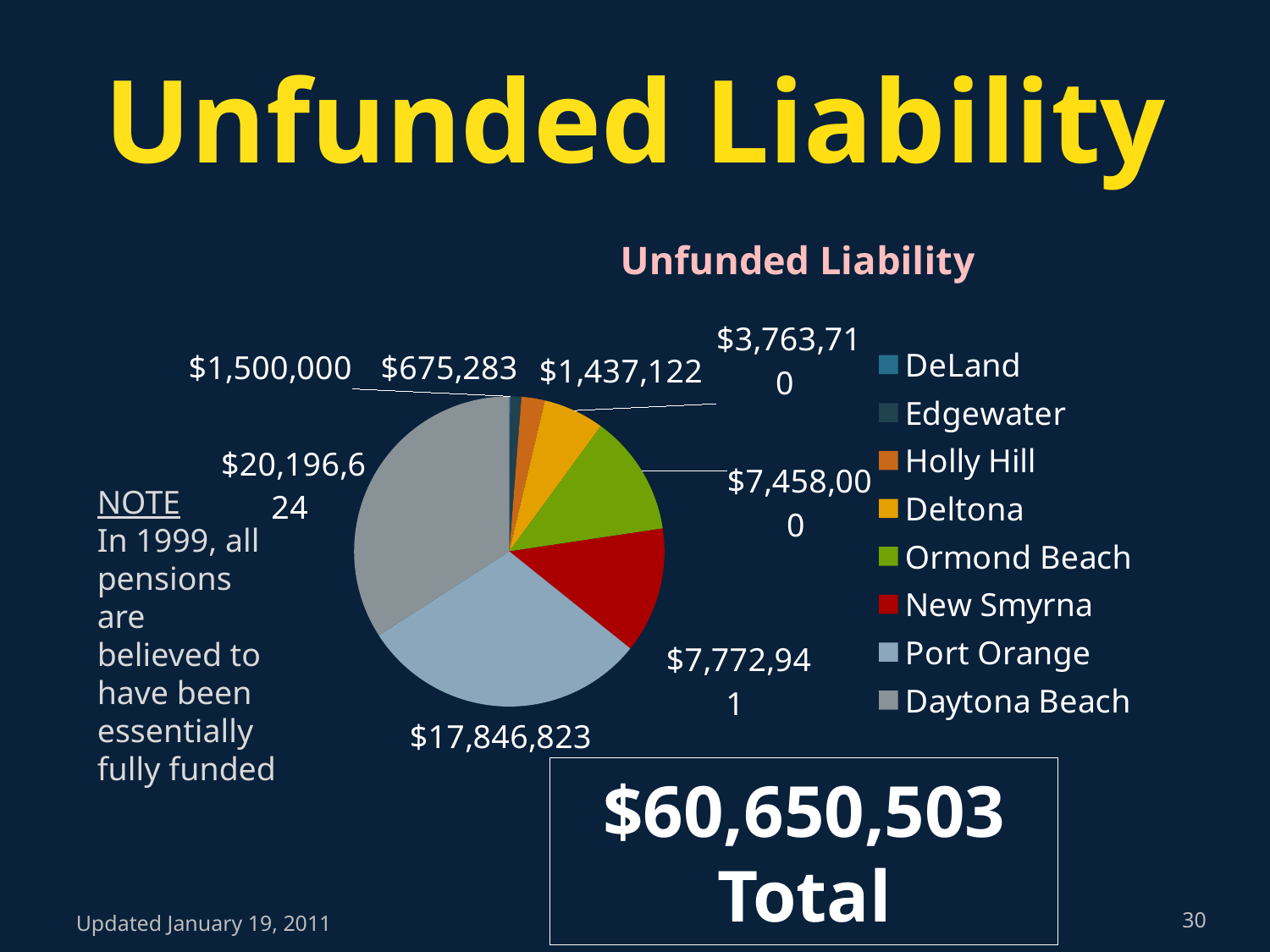
What is the unfunded liability for Daytona Beach? $20,196,624 Which city has the largest unfunded liability in the pie chart? Daytona Beach How many entries does the chart legend list? 8 What is the unfunded liability for Ormond Beach? $7,458,000 What type of chart is shown on the slide? pie chart What is the unfunded liability for New Smyrna? $7,772,941 What is the unfunded liability for Deltona? $3,763,710 How many slices does the pie chart have? 8 What is the total unfunded liability shown on the slide? $60,650,503 What is the title of the chart? Unfunded Liability Which has the larger unfunded liability, Port Orange or Daytona Beach? Daytona Beach What is the unfunded liability for Port Orange? $17,846,823